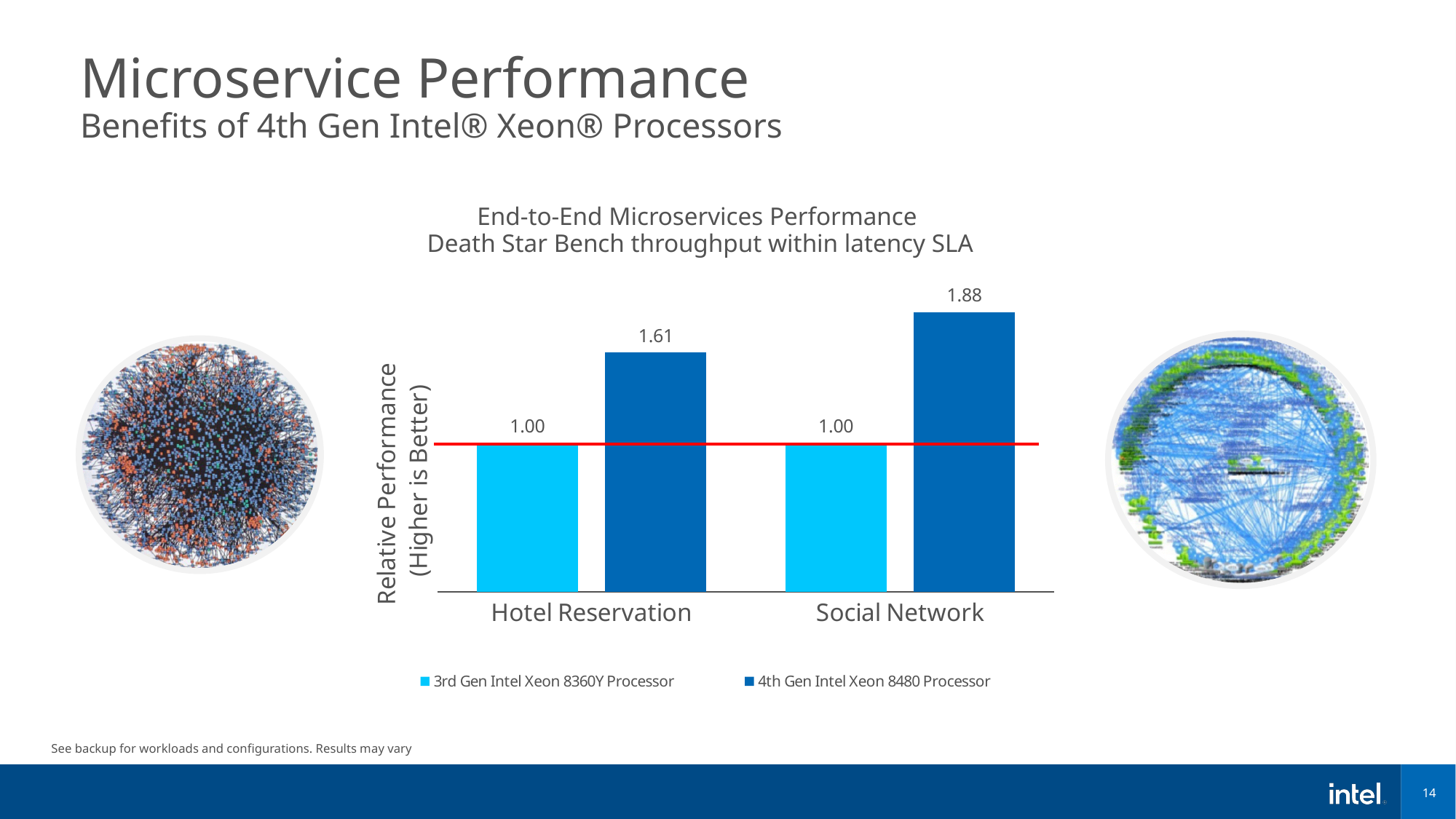
Which workload shows the highest relative performance for the 4th Gen Intel Xeon 8480 Processor? Social Network How many workload categories are shown on the x axis? 2 How many series does the legend list? 2 What is the relative performance of the 4th Gen Intel Xeon 8480 Processor for Hotel Reservation? 1.61 What is the relative performance of the 3rd Gen Intel Xeon 8360Y Processor for Hotel Reservation? 1.00 What is the relative performance of the 4th Gen Intel Xeon 8480 Processor for Social Network? 1.88 What is the label of the y axis? Relative Performance (Higher is Better) What is the difference between the 4th Gen Intel Xeon 8480 Processor values for Social Network and Hotel Reservation? 0.27 What is the title of the chart? End-to-End Microservices Performance Death Star Bench throughput within latency SLA Which is larger for Hotel Reservation: the 3rd Gen Intel Xeon 8360Y Processor or the 4th Gen Intel Xeon 8480 Processor? 4th Gen Intel Xeon 8480 Processor What kind of chart is shown on the slide? Bar chart What is the difference between the 4th Gen Intel Xeon 8480 Processor and the 3rd Gen Intel Xeon 8360Y Processor for Social Network? 0.88